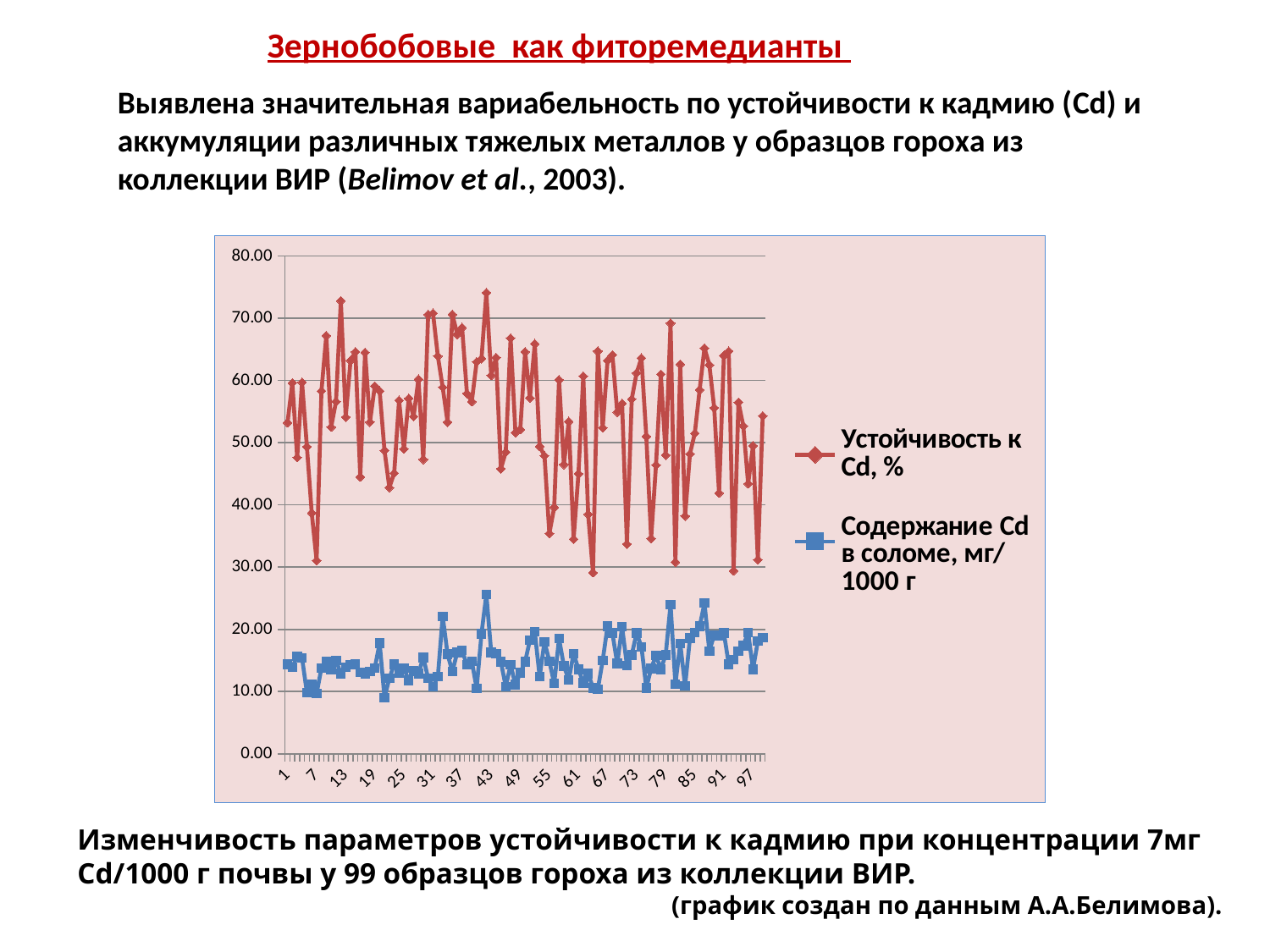
Is the lowest value of the Устойчивость к Cd, % series greater or less than 40.00? less What kind of chart is shown on the slide? line chart How many pea samples are plotted in the chart, according to the slide caption? 99 Is the highest value of the Устойчивость к Cd, % series greater or less than 70.00? greater How many series does the chart legend list? 2 What is the name of the series drawn with blue square markers? Содержание Cd в соломе, мг/1000 г Is the value of Содержание Cd в соломе, мг/1000 г at sample 1 greater or less than 20.00? less What is the maximum value shown on the vertical axis of the chart? 80.00 What is the name of the series drawn with red diamond markers? Устойчивость к Cd, % Which series has higher values overall, Устойчивость к Cd, % or Содержание Cd в соломе, мг/1000 г? Устойчивость к Cd, %